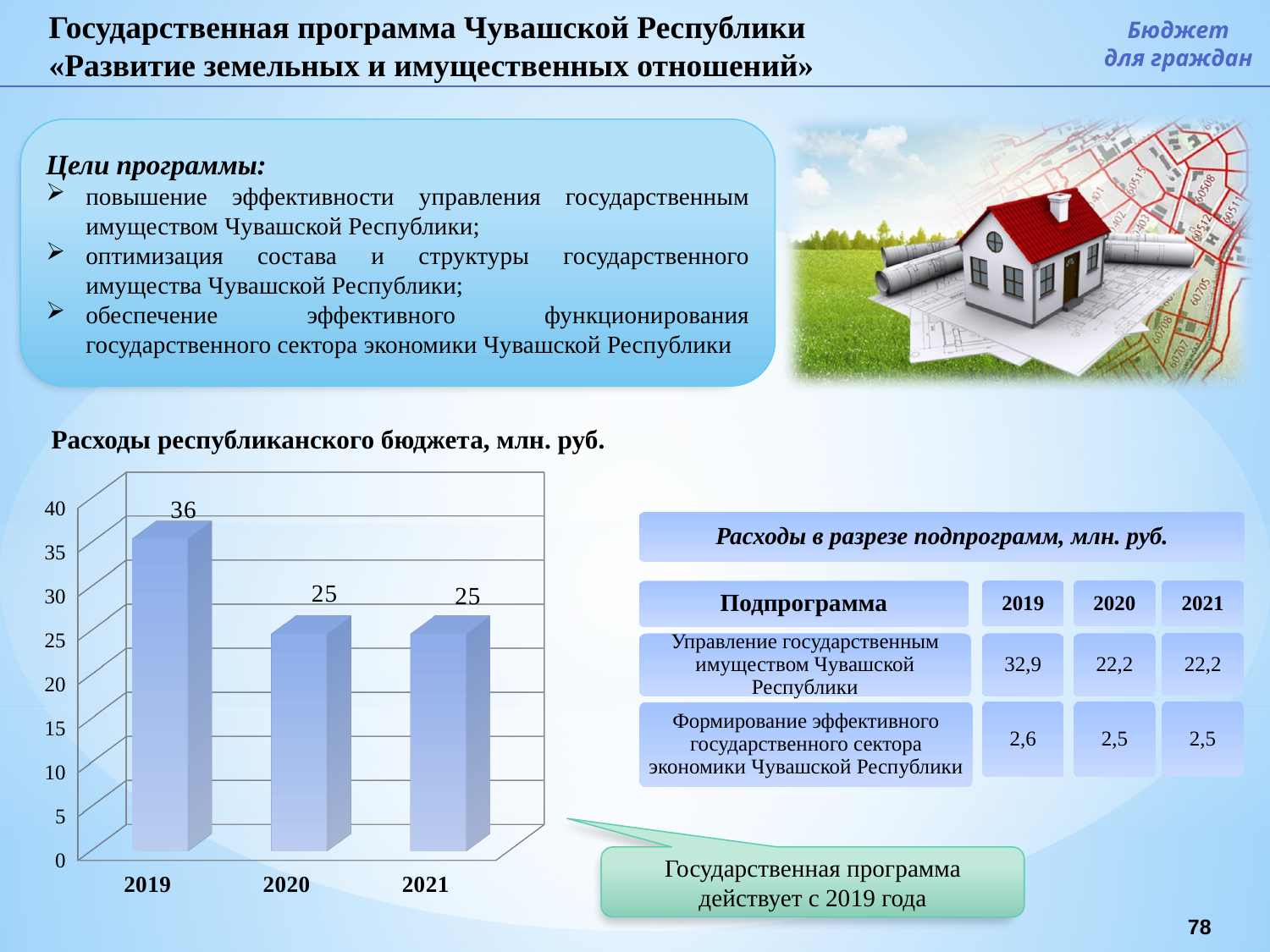
Is the value for 2019 in the chart "Расходы республиканского бюджета, млн. руб." greater or less than 35? greater What is the maximum value shown on the vertical axis of the chart "Расходы республиканского бюджета, млн. руб."? 40 What is the value for 2020 in the chart "Расходы республиканского бюджета, млн. руб."? 25 Is the value for 2020 in the chart "Расходы республиканского бюджета, млн. руб." greater or less than 30? less Do the values in the chart "Расходы республиканского бюджета, млн. руб." rise or fall from 2019 to 2020? fall What is the value for 2019 in the chart "Расходы республиканского бюджета, млн. руб."? 36 Which is larger in the chart "Расходы республиканского бюджета, млн. руб.": the value for 2019 or the value for 2021? 2019 How many years are shown on the x axis of the chart "Расходы республиканского бюджета, млн. руб."? 3 Which year has the highest value in the chart "Расходы республиканского бюджета, млн. руб."? 2019 What kind of chart is "Расходы республиканского бюджета, млн. руб."? bar chart What is the value for 2021 in the chart "Расходы республиканского бюджета, млн. руб."? 25 What is the difference between the values for 2019 and 2020 in the chart "Расходы республиканского бюджета, млн. руб."? 11